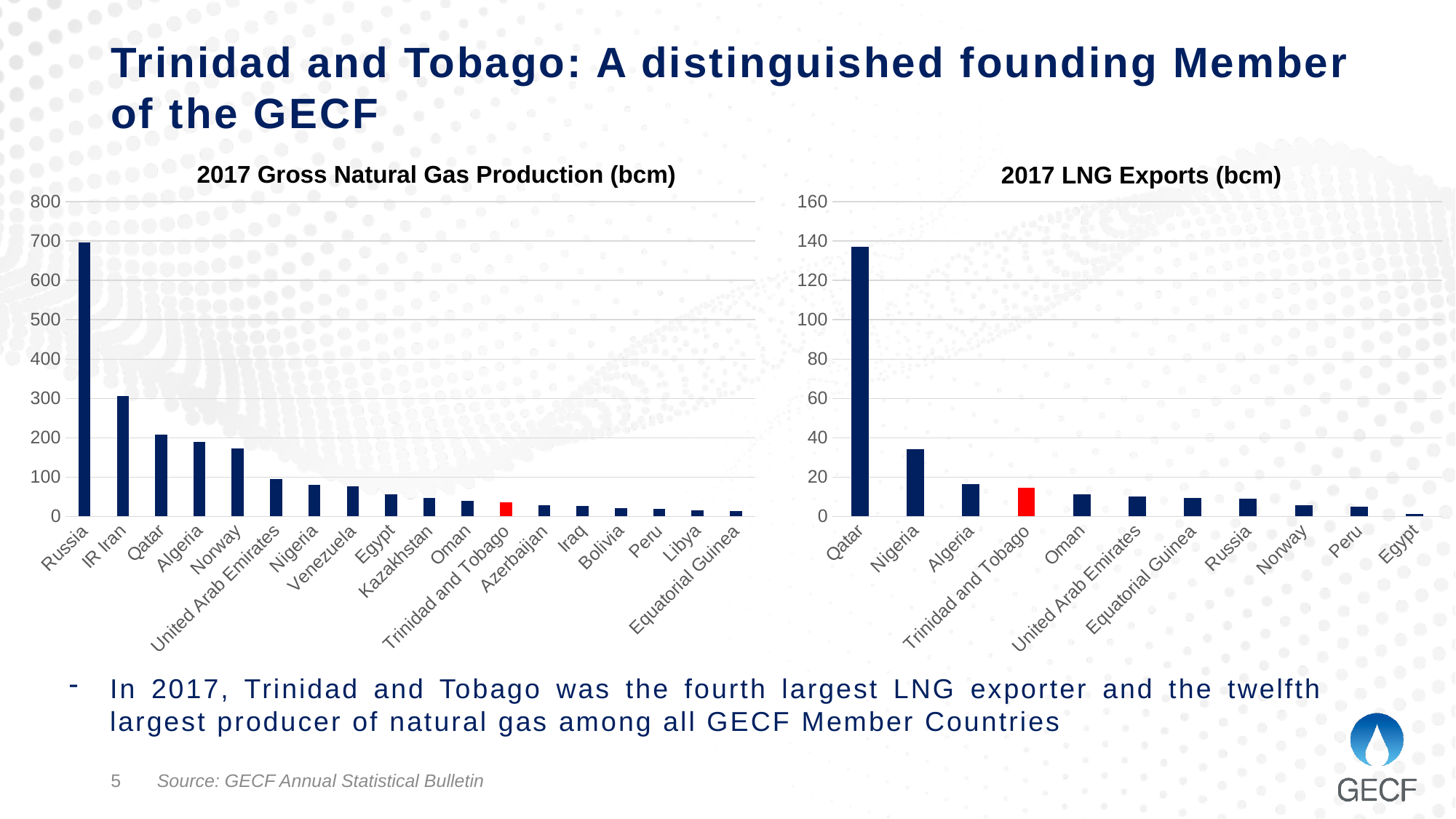
In the 2017 LNG Exports (bcm) chart, which country's bar is coloured red? Trinidad and Tobago How many countries are shown in the 2017 Gross Natural Gas Production (bcm) chart? 18 In the 2017 LNG Exports (bcm) chart, is the value for Trinidad and Tobago greater or less than 20? less In the 2017 LNG Exports (bcm) chart, is the value for Qatar greater or less than 120? greater What kind of chart is the 2017 Gross Natural Gas Production (bcm) chart? bar chart In the 2017 Gross Natural Gas Production (bcm) chart, which country has the highest value? Russia In the 2017 Gross Natural Gas Production (bcm) chart, is the value for Norway greater or less than 200? less In the 2017 LNG Exports (bcm) chart, which is larger, the value for Nigeria or the value for Algeria? Nigeria In the 2017 LNG Exports (bcm) chart, which country has the lowest value? Egypt How many countries are shown in the 2017 LNG Exports (bcm) chart? 11 In the 2017 LNG Exports (bcm) chart, which country has the highest value? Qatar